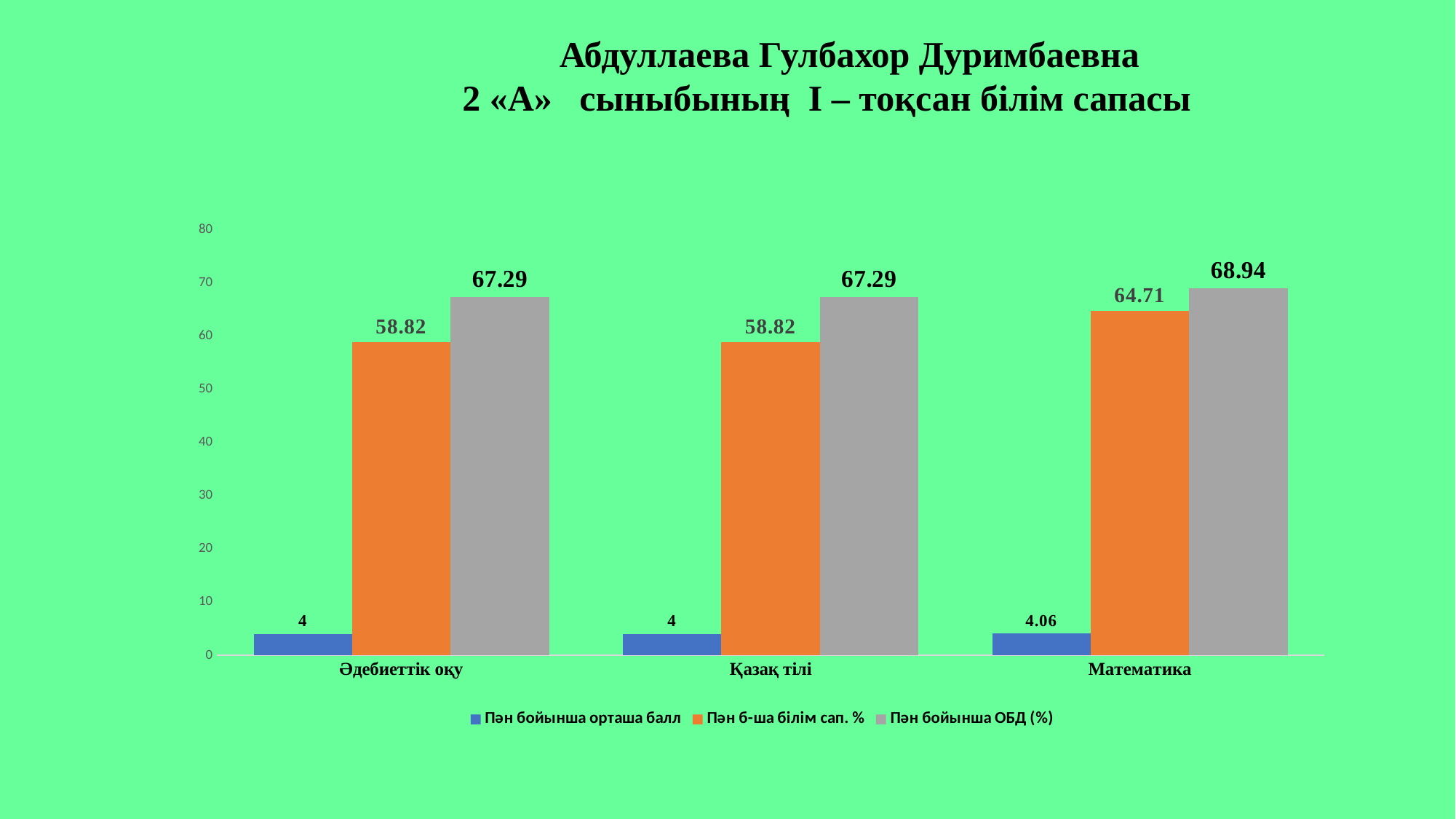
What is the value of 'Пән бойынша ОБД (%)' for Әдебиеттік оқу? 67.29 How many categories are shown on the x axis? 3 What is the difference between 'Пән бойынша ОБД (%)' and 'Пән б-ша білім сап. %' for Математика? 4.23 What is the value of 'Пән б-ша білім сап. %' for Математика? 64.71 What kind of chart is shown on the slide? Bar chart Is the value of 'Пән бойынша ОБД (%)' for Қазақ тілі greater or less than 60? greater Which category has the highest value for 'Пән бойынша ОБД (%)'? Математика How many series does the legend list? 3 Which is larger: 'Пән б-ша білім сап. %' for Математика or for Әдебиеттік оқу? Математика What is the value of 'Пән бойынша орташа балл' for Математика? 4.06 What is the value of 'Пән б-ша білім сап. %' for Қазақ тілі? 58.82 What is the difference between the 'Пән б-ша білім сап. %' values for Математика and Қазақ тілі? 5.89